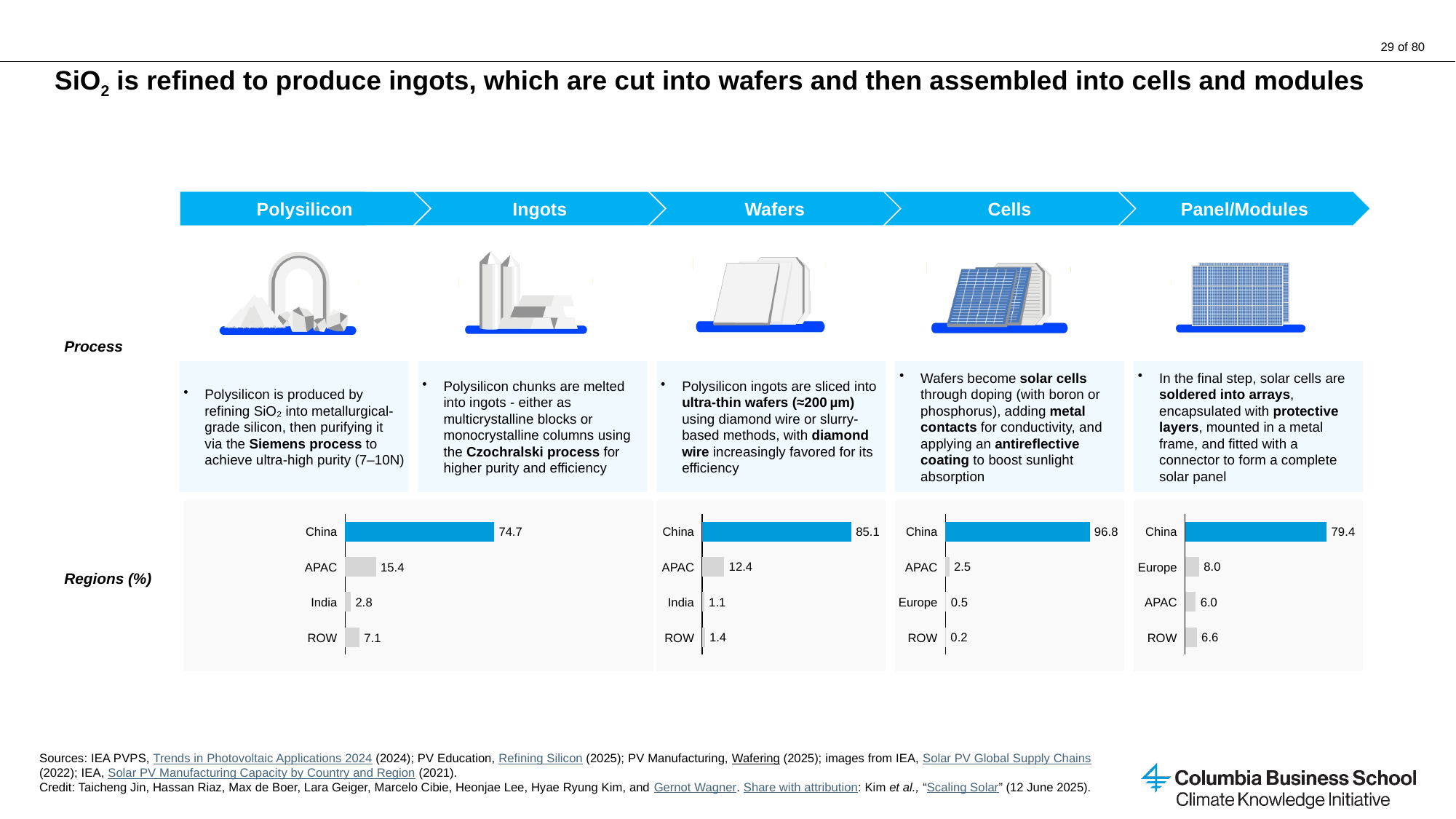
In the Regions (%) chart under Wafers, what is the difference between China and APAC? 72.7 In the Regions (%) chart under Panel/Modules, what is the value for Europe? 8.0 In the leftmost Regions (%) chart (under Polysilicon), what is the value for APAC? 15.4 In the Regions (%) chart under Cells, what is the value for China? 96.8 In the Regions (%) chart under Panel/Modules, which is larger, APAC or ROW? ROW In the leftmost Regions (%) chart (under Polysilicon), what is the value for China? 74.7 How many regions are shown in the Regions (%) chart under Panel/Modules? 4 What kind of chart is used for the Regions (%) data under Cells? Bar chart In the Regions (%) chart under Wafers, which is larger, India or ROW? ROW In the Regions (%) chart under Wafers, what is the value for China? 85.1 In the Regions (%) chart under Cells, which region has the lowest value? ROW In the leftmost Regions (%) chart (under Polysilicon), which region has the lowest value? India